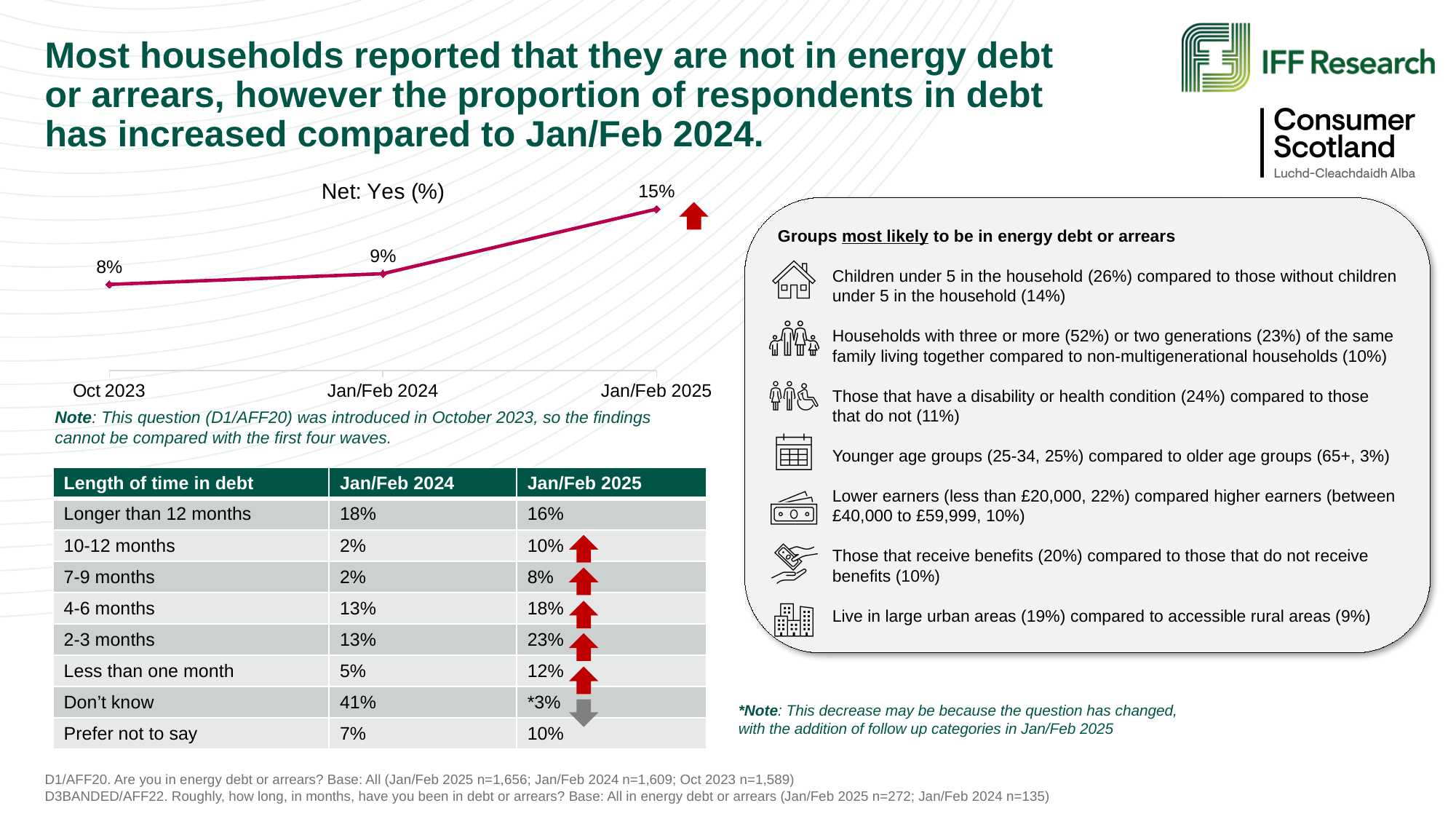
What is the value for Jan/Feb 2025 in the Net: Yes (%) line chart? 15% Which time point has the highest value in the Net: Yes (%) line chart? Jan/Feb 2025 Do the values in the Net: Yes (%) line chart rise or fall from Oct 2023 to Jan/Feb 2025? Rise What is the difference between the Jan/Feb 2024 and Oct 2023 values in the Net: Yes (%) line chart? 1% What is the value for Oct 2023 in the Net: Yes (%) line chart? 8% In the Net: Yes (%) line chart, which is larger: the value for Jan/Feb 2025 or the value for Oct 2023? Jan/Feb 2025 What is the difference between the Jan/Feb 2025 and Jan/Feb 2024 values in the Net: Yes (%) line chart? 6% What kind of chart is the Net: Yes (%) chart? Line chart What is the title of the line chart on the slide? Net: Yes (%) What is the value for Jan/Feb 2024 in the Net: Yes (%) line chart? 9% Which time point has the lowest value in the Net: Yes (%) line chart? Oct 2023 How many data points are plotted in the Net: Yes (%) line chart? 3